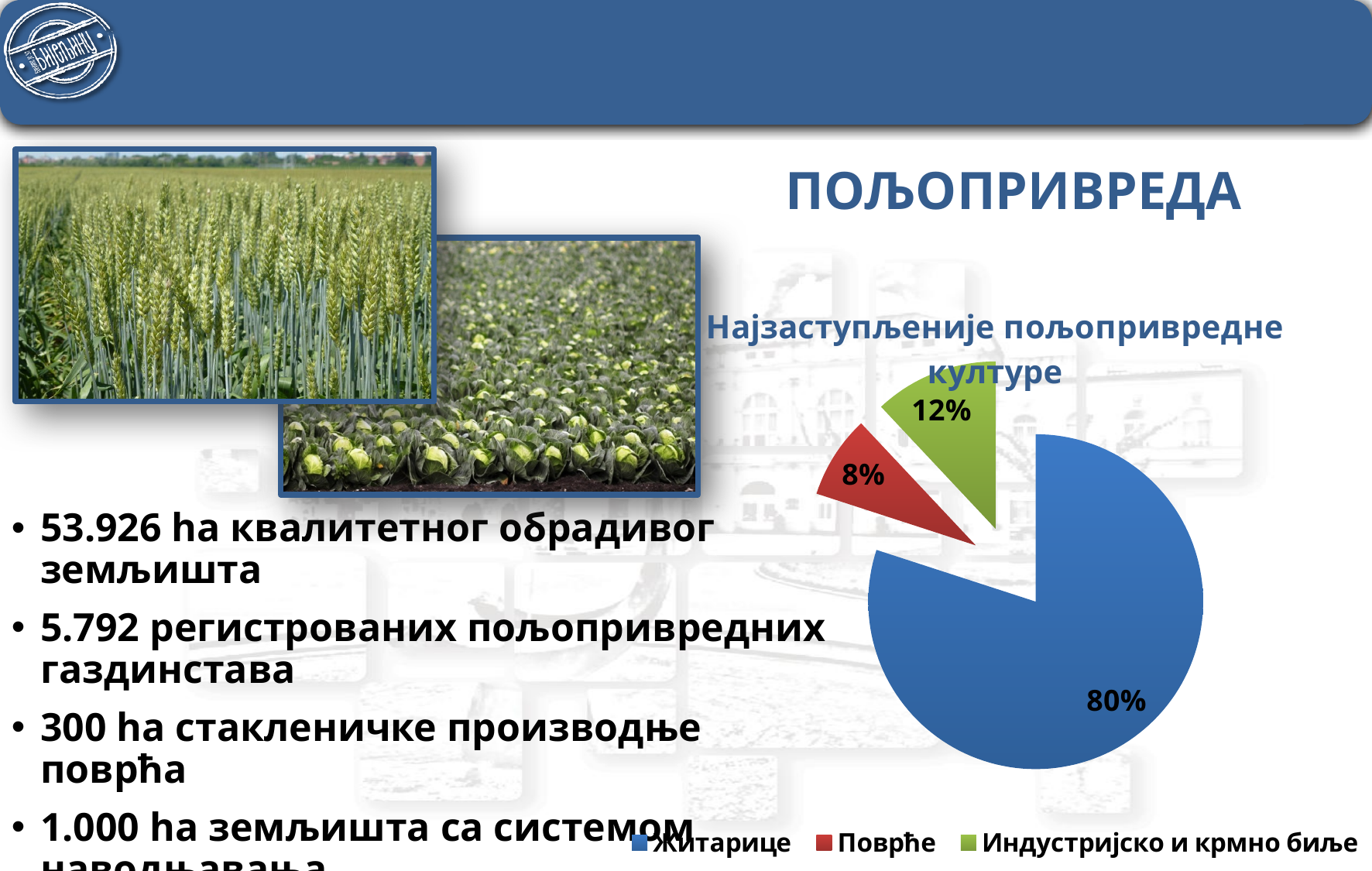
Which category has the smallest slice of the pie? Поврће What share of the pie does Житарице have? 80% What kind of chart is shown on the slide? pie chart How many slices does the pie chart have? 3 What share of the pie does Поврће have? 8% Which is larger, the share for Поврће or the share for Индустријско и крмно биље? Индустријско и крмно биље What share of the pie does Индустријско и крмно биље have? 12% What is the title of the chart? Најзаступљеније пољопривредне културе What is the difference in percentage points between Житарице and Индустријско и крмно биље? 68 What colour is the slice for Поврће? red Which category has the largest slice of the pie? Житарице How many entries does the legend list? 3